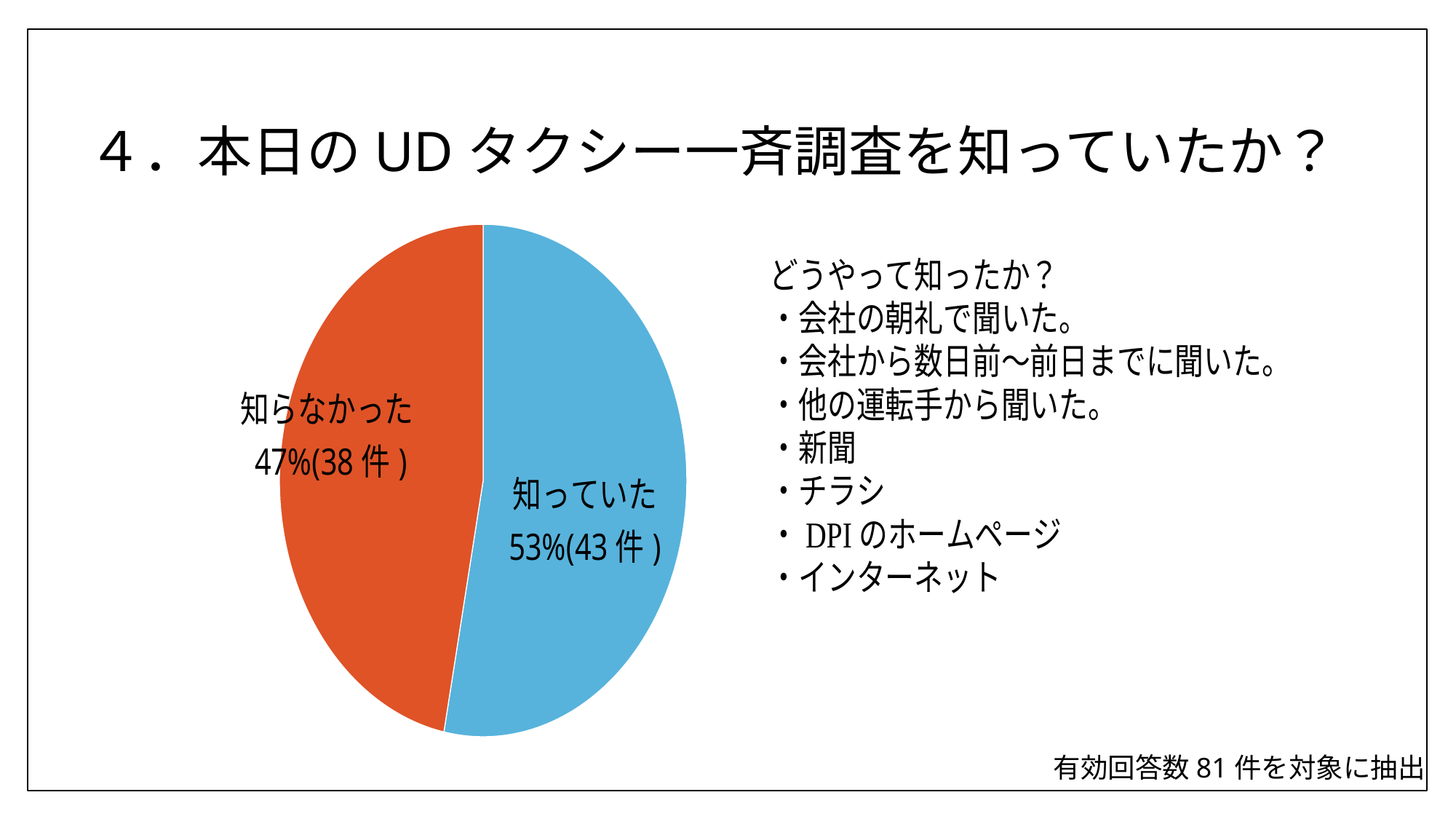
How many slices does the pie chart have? 2 What percentage of respondents answered 知っていた? 53% Which has more responses, 知っていた or 知らなかった? 知っていた What is the difference in number of responses between 知っていた and 知らなかった? 5 How many responses (件) are in the 知っていた slice? 43 件 Which slice of the pie is the smallest? 知らなかった How many responses (件) are in the 知らなかった slice? 38 件 What percentage of respondents answered 知らなかった? 47% Which slice of the pie is the largest? 知っていた What kind of chart is shown on the slide? pie chart What colour is the 知っていた slice? blue What is the difference in percentage points between 知っていた and 知らなかった? 6